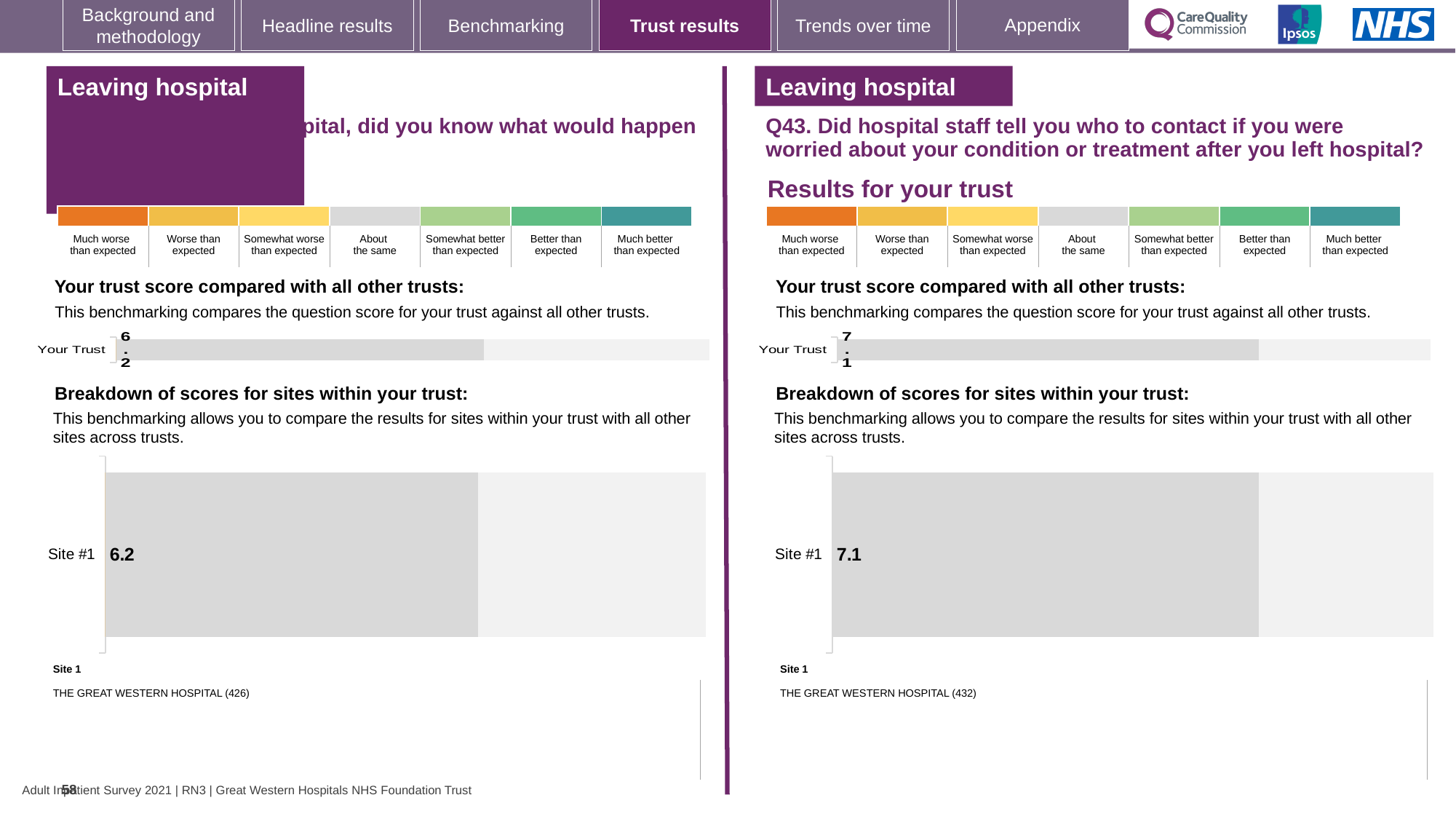
In the Site #1 chart on the left half of the slide, what is the value for Site #1? 6.2 Which site name is listed under the breakdown chart on the left half of the slide? THE GREAT WESTERN HOSPITAL (426) What is the difference between the Site #1 score on the right half of the slide (Q43) and the Site #1 score on the left half? 0.9 How many sites are shown in the breakdown chart on the left half of the slide? 1 In the Site #1 chart on the right half of the slide (Q43), what is the value for Site #1? 7.1 On the right half of the slide (Q43), what is the score shown for Your Trust? 7.1 Is the Your Trust score on the right half of the slide (Q43) greater or less than 7? greater How many sites are shown in the breakdown chart on the right half of the slide (Q43)? 1 On the left half of the slide, what is the score shown for Your Trust? 6.2 What kind of chart is used to show the Your Trust score on the right half of the slide (Q43)? Bar chart Which site name is listed under the breakdown chart on the right half of the slide (Q43)? THE GREAT WESTERN HOSPITAL (432) Which is larger: the Your Trust score on the left half of the slide or the Your Trust score on the right half (Q43)? Q43 (right half)